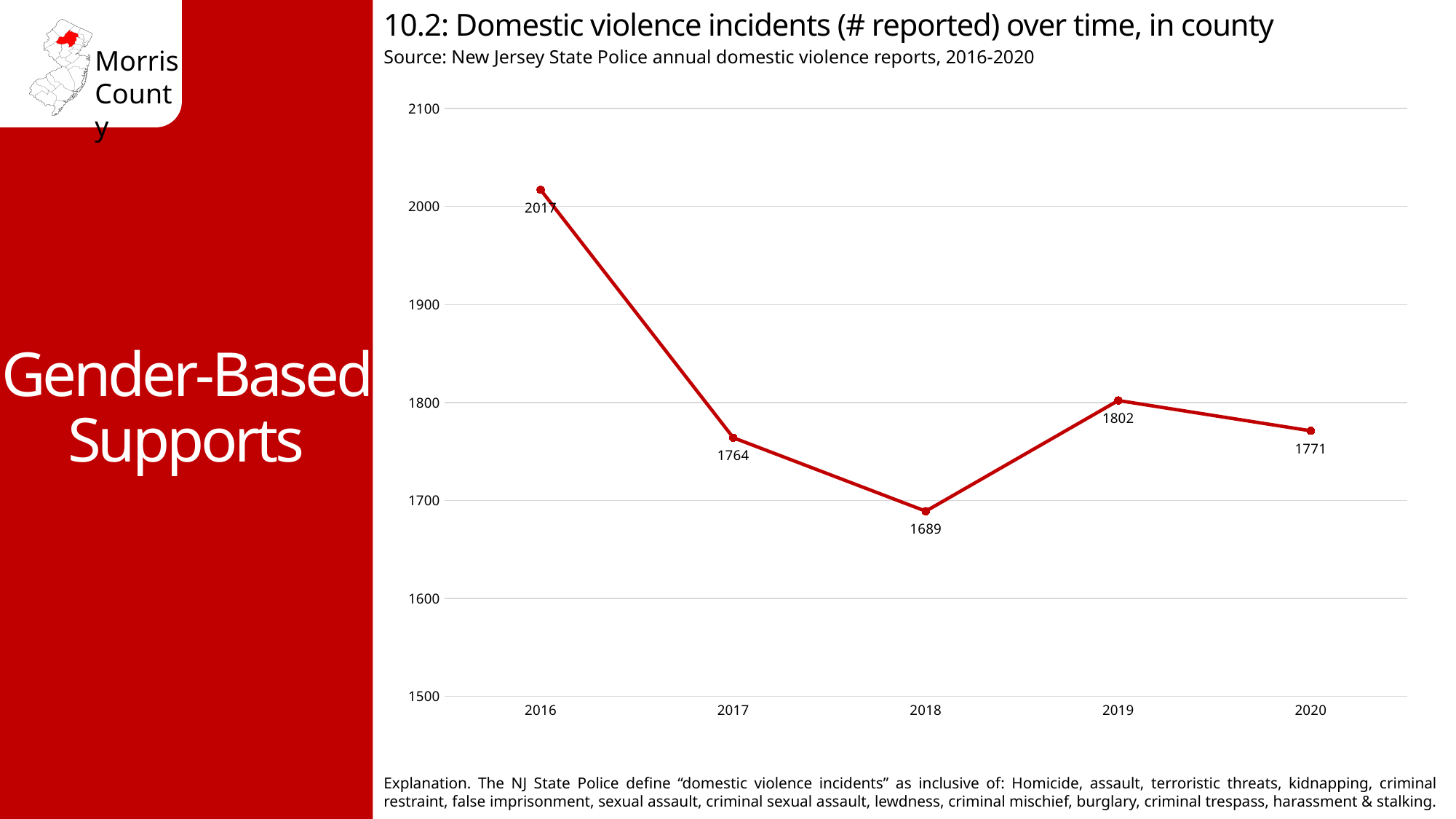
What is the difference between the number of incidents reported in 2016 and in 2018? 328 How many domestic violence incidents were reported in 2016? 2017 What kind of chart is shown on the slide? line chart Which year had more reported incidents, 2017 or 2019? 2019 What is the difference between the number of incidents reported in 2019 and in 2020? 31 Which year had the highest number of reported domestic violence incidents? 2016 How many domestic violence incidents were reported in 2018? 1689 How many domestic violence incidents were reported in 2020? 1771 Is the value for 2017 greater or less than 1800? less How many years are plotted on the chart? 5 Which year had the lowest number of reported domestic violence incidents? 2018 Did the number of reported incidents rise or fall from 2016 to 2018? fall